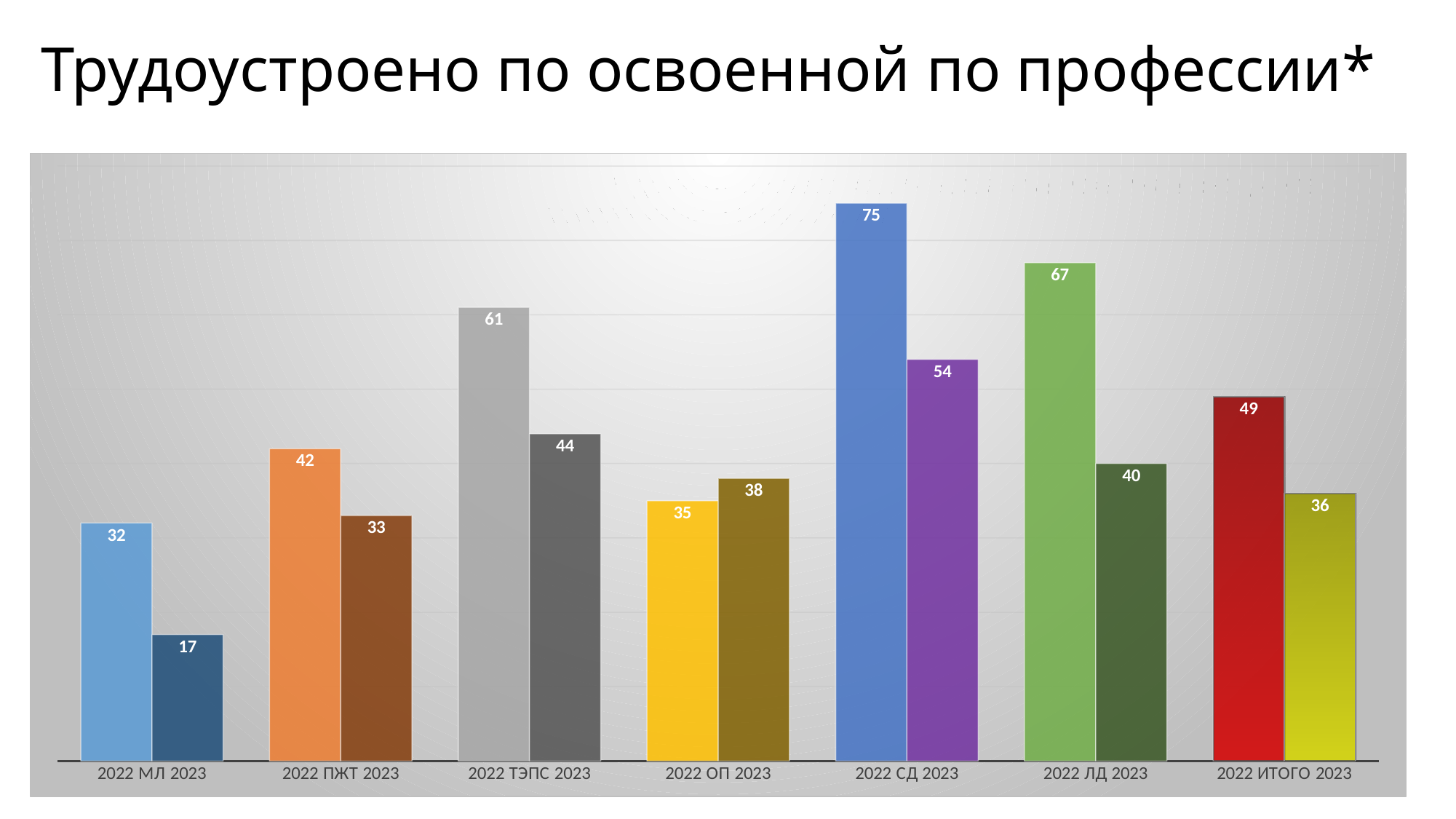
What is the title of the slide? Трудоустроено по освоенной по профессии* What is the 2023 value for МЛ? 17 What is the 2022 value for СД? 75 Which category has the lowest 2023 value? МЛ What is the difference between the 2022 and 2023 values for ЛД? 27 What is the 2022 value for ТЭПС? 61 What is the difference between the 2022 and 2023 values for ПЖТ? 9 How many categories (professions) are shown on the x axis? 7 For ОП, which year has the larger value, 2022 or 2023? 2023 Which category has the highest 2022 value? СД What is the 2023 value for ИТОГО? 36 What kind of chart is shown on the slide? Bar chart